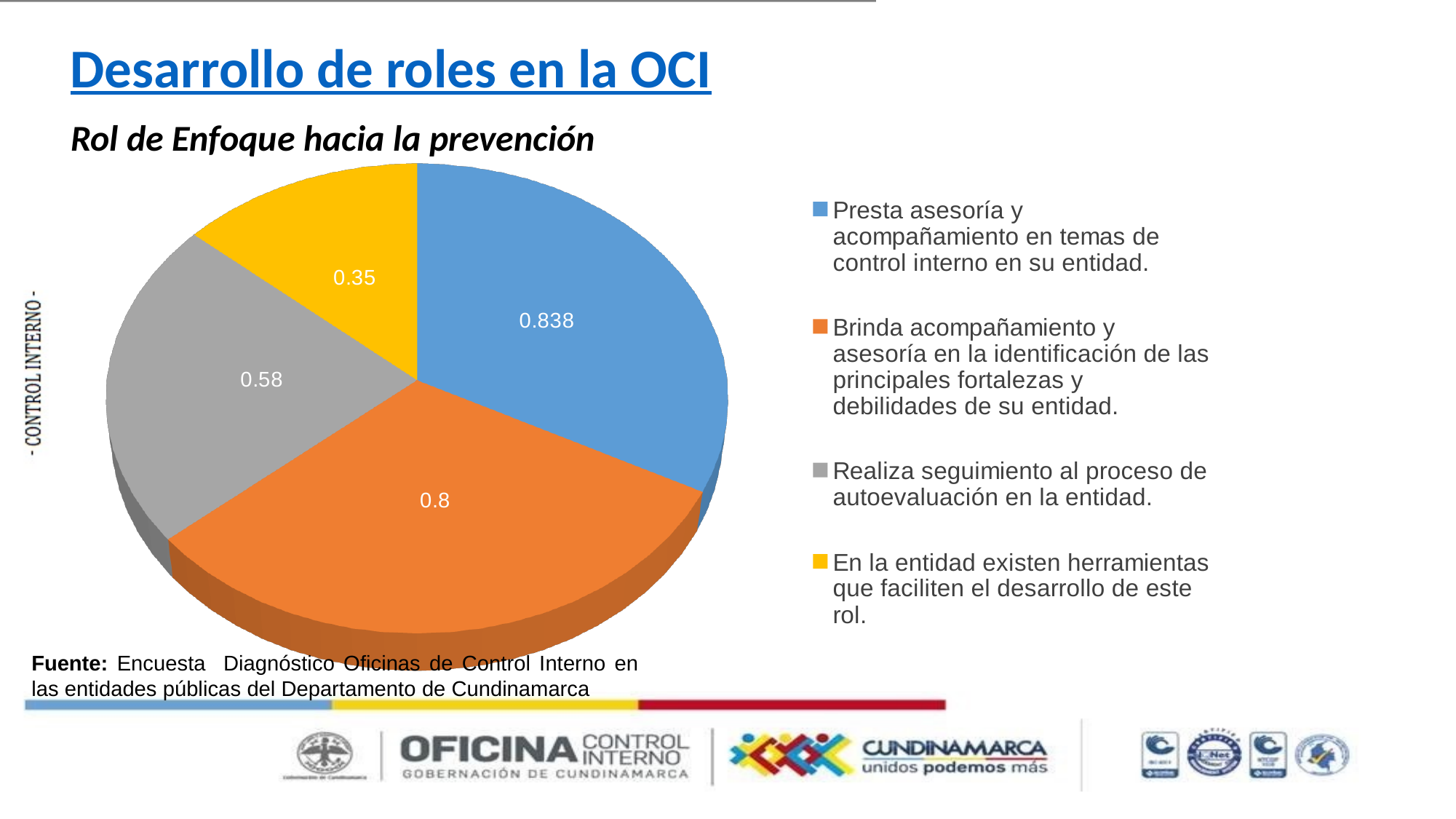
What is the difference between the value for 'Brinda acompañamiento y asesoría en la identificación de las principales fortalezas y debilidades de su entidad.' and the value for 'Realiza seguimiento al proceso de autoevaluación en la entidad.'? 0.22 What is the difference between the value for 'Presta asesoría y acompañamiento en temas de control interno en su entidad.' and the value for 'En la entidad existen herramientas que faciliten el desarrollo de este rol.'? 0.488 What colour is the slice for 'Realiza seguimiento al proceso de autoevaluación en la entidad.'? Gray How many slices does the pie chart have? 4 Which has the larger value: 'Presta asesoría y acompañamiento en temas de control interno en su entidad.' or 'Brinda acompañamiento y asesoría en la identificación de las principales fortalezas y debilidades de su entidad.'? Presta asesoría y acompañamiento en temas de control interno en su entidad. What is the value shown for the slice 'Realiza seguimiento al proceso de autoevaluación en la entidad.'? 0.58 Which legend category has the lowest value in the pie chart? En la entidad existen herramientas que faciliten el desarrollo de este rol. What is the value shown for the slice 'En la entidad existen herramientas que faciliten el desarrollo de este rol.'? 0.35 What kind of chart is shown on the slide? Pie chart What is the value shown for the slice 'Brinda acompañamiento y asesoría en la identificación de las principales fortalezas y debilidades de su entidad.'? 0.8 What is the value shown for the slice 'Presta asesoría y acompañamiento en temas de control interno en su entidad.'? 0.838 Which legend category has the highest value in the pie chart? Presta asesoría y acompañamiento en temas de control interno en su entidad.